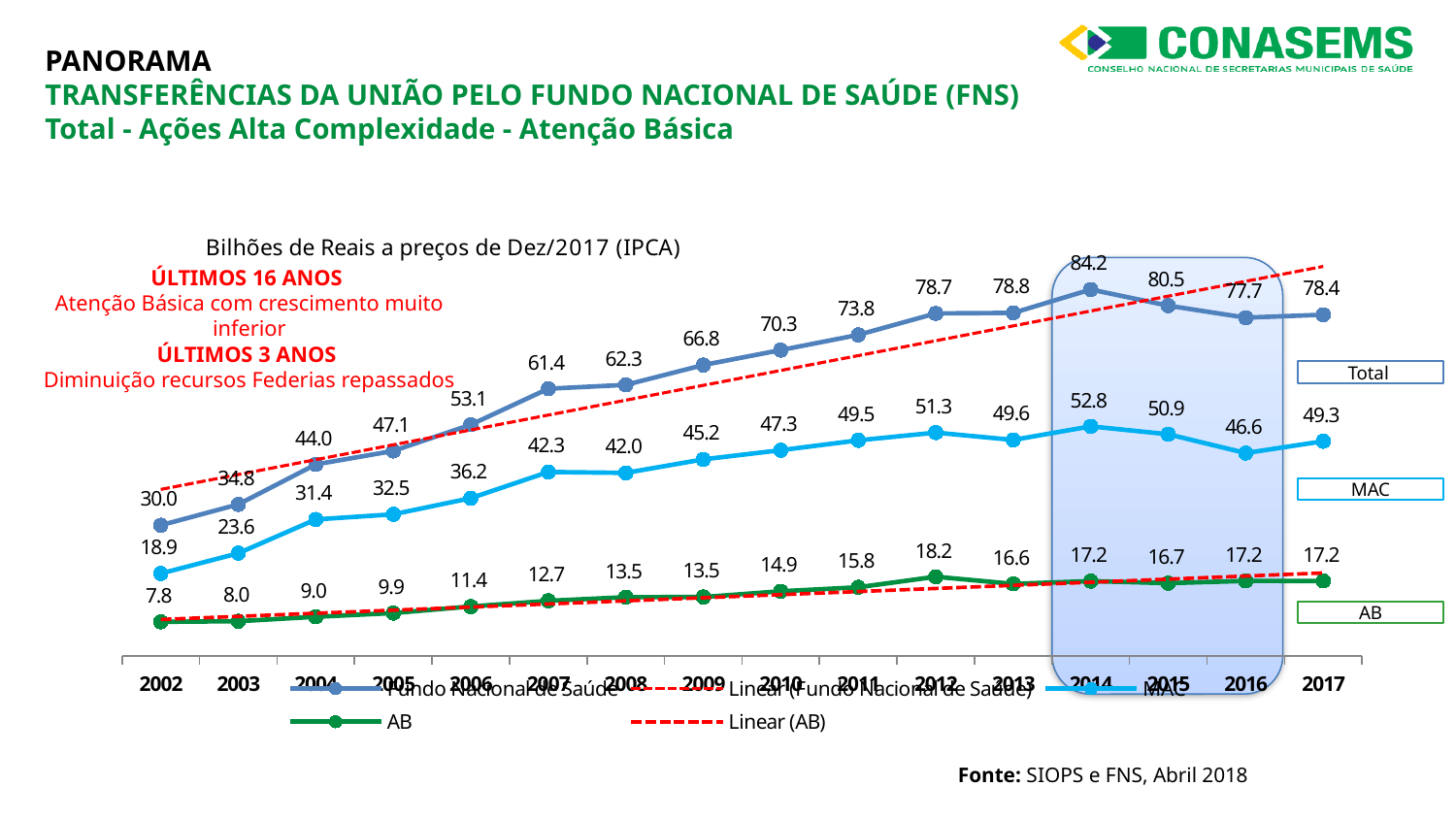
In which year does the Fundo Nacional de Saúde (Total) series reach its highest value? 2014 In which year is the MAC series at its lowest value? 2002 How many entries does the legend list? 5 What is the value of the Fundo Nacional de Saúde (Total) series in 2014? 84.2 What is the difference between the Total value in 2017 and the Total value in 2002? 48.4 What is the difference between the MAC value and the AB value in 2014? 35.6 In which year is the AB series at its highest value? 2012 What is the AB value in 2002? 7.8 How many years are plotted on the x axis? 16 What is the MAC value in 2017? 49.3 What type of chart is shown on the slide? Line chart Which is larger, the MAC value in 2012 or the MAC value in 2013? MAC value in 2012 (51.3)